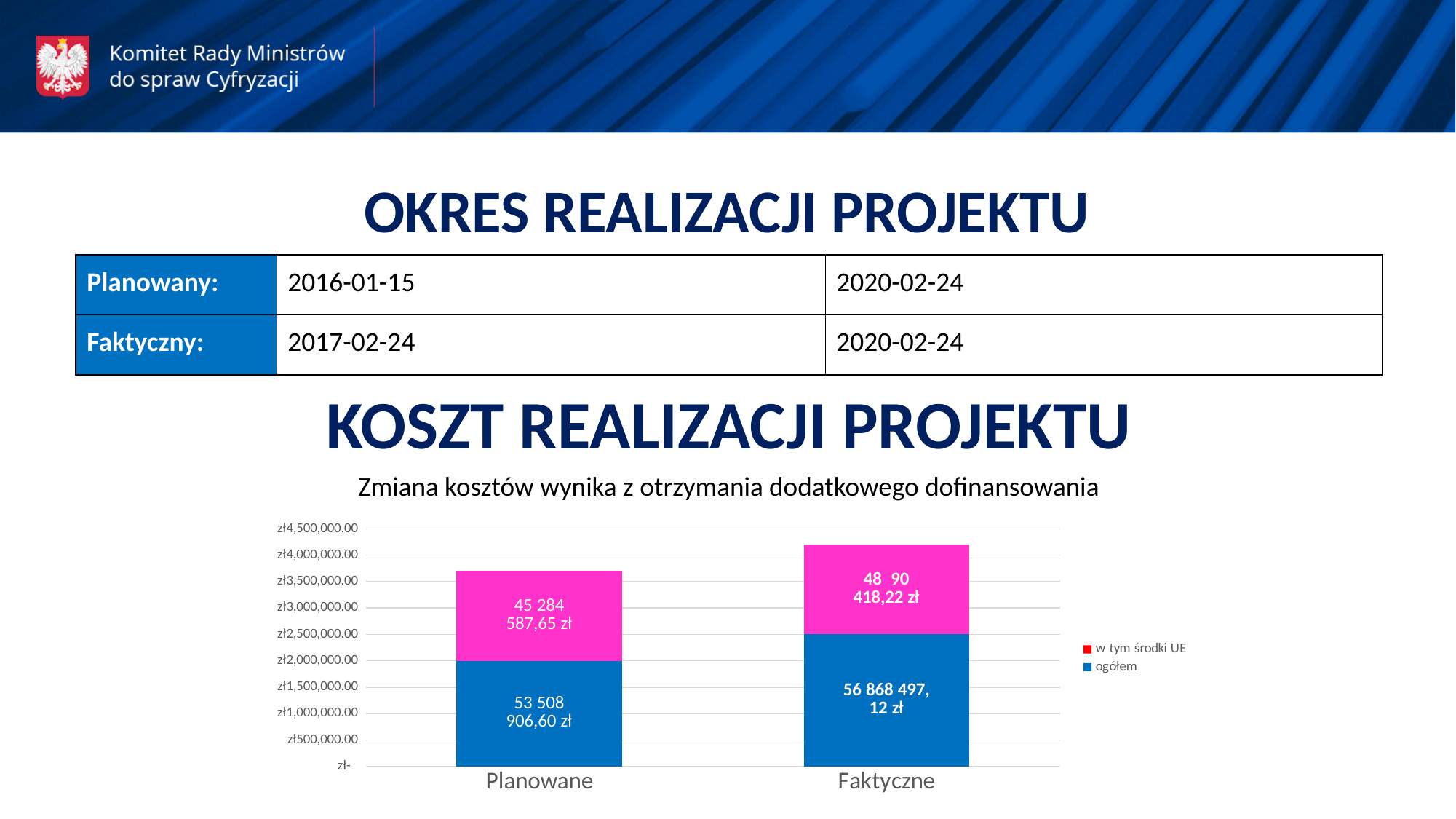
How many series does the legend of the cost chart list? 2 What is the title of the cost chart? Zmiana kosztów wynika z otrzymania dodatkowego dofinansowania Is the total height of the Planowane bar greater or less than zł3,500,000.00? greater Is the total height of the Faktyczne bar greater or less than zł4,000,000.00? greater How many categories are shown on the x axis of the cost chart? 2 What kind of chart is shown under 'Koszt realizacji projektu'? stacked bar chart Which bar is taller overall in the cost chart, Planowane or Faktyczne? Faktyczne What data label is printed on the 'ogółem' segment of the Planowane bar? 53 508 906,60 zł What data label is printed on the 'ogółem' segment of the Faktyczne bar? 56 868 497,12 zł Do the total bar heights rise or fall from Planowane to Faktyczne? rise Which colour represents the 'ogółem' series in the cost chart? blue